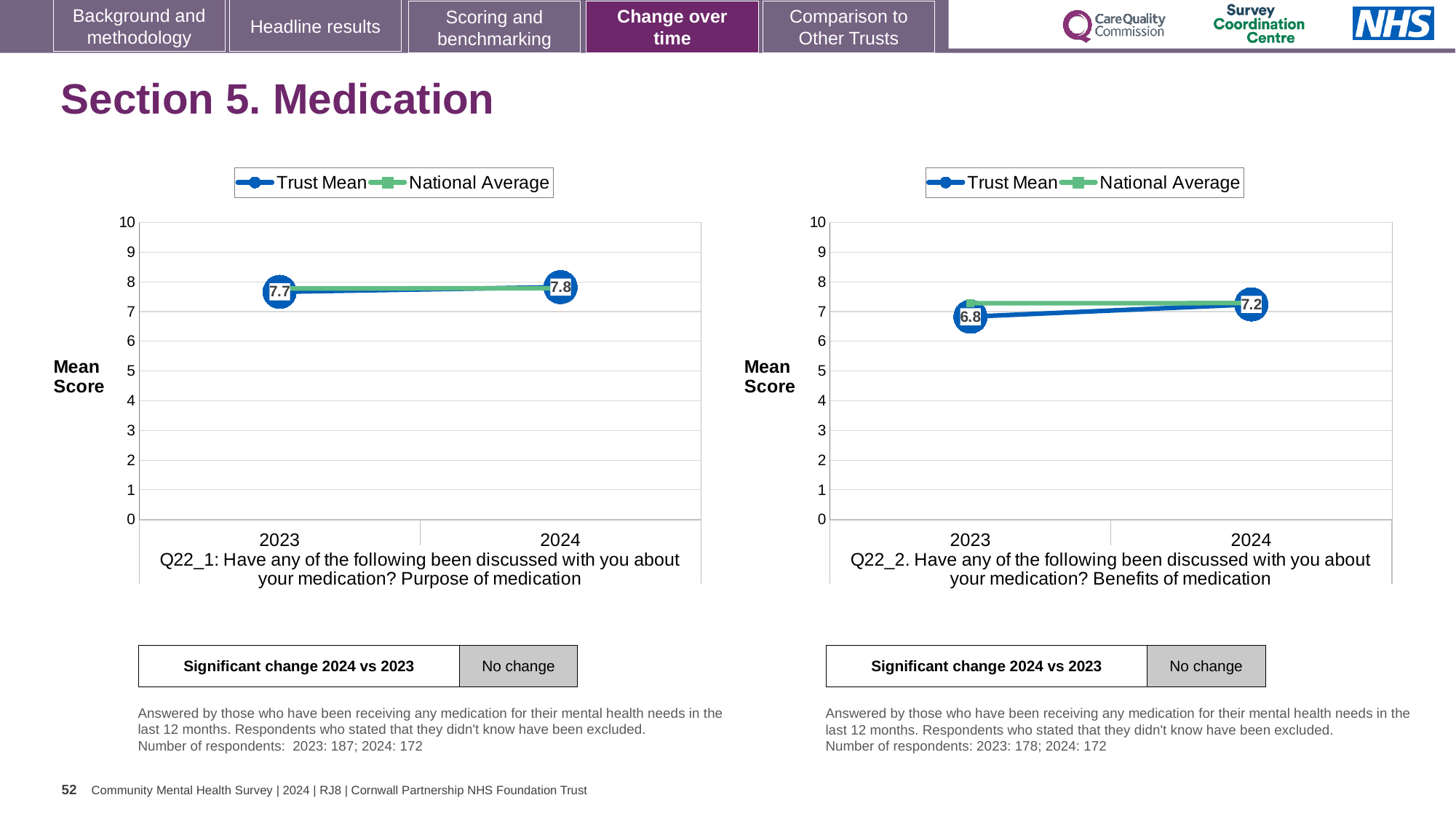
In the Q22_2 chart (right), which is larger in 2023: the Trust Mean or the National Average? National Average What type of chart is the Q22_1 chart (left)? line chart In the Q22_1 chart (left), what is the Trust Mean for 2023? 7.7 How many years are shown on the x axis of the Q22_1 chart (left)? 2 In the Q22_1 chart (left), what is the difference between the Trust Mean for 2024 and 2023? 0.1 In the Q22_2 chart (right), what is the Trust Mean for 2024? 7.2 In the Q22_2 chart (right), what is the Trust Mean for 2023? 6.8 In the Q22_2 chart (right), by how much did the Trust Mean change from 2023 to 2024? 0.4 In the Q22_1 chart (left), what is the Trust Mean for 2024? 7.8 How many series does the legend of the Q22_2 chart (right) list? 2 In the Q22_2 chart (right), is the National Average for 2023 greater or less than 5? greater In the Q22_2 chart (right), does the Trust Mean rise or fall from 2023 to 2024? rise